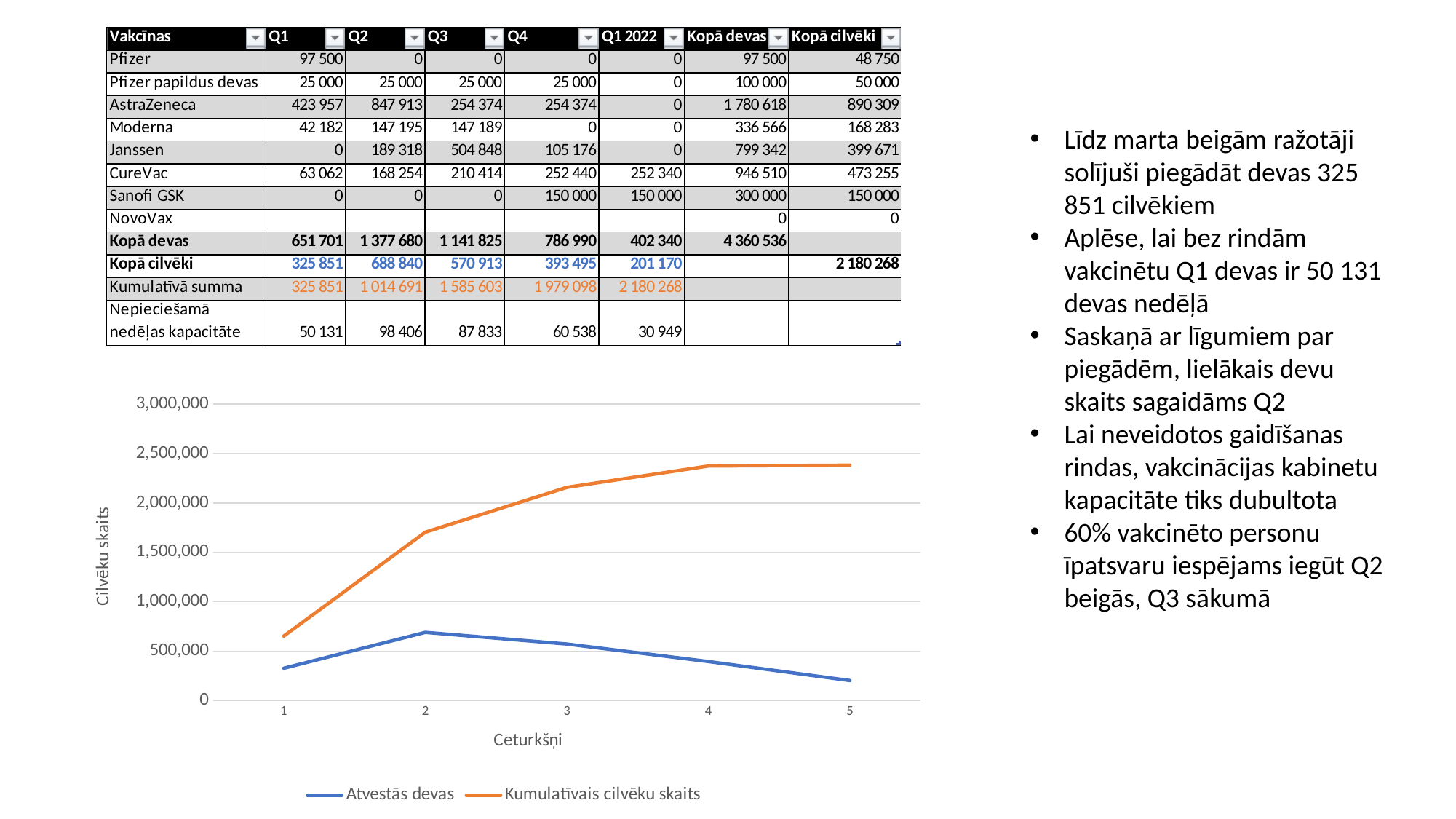
Does the Kumulatīvais cilvēku skaits line rise or fall from point 1 to point 5? rise At which x-axis point is the Atvestās devas line at its lowest value? 5 Is the value of Kumulatīvais cilvēku skaits at point 5 greater or less than 2,500,000? less At which x-axis point does the Atvestās devas line reach its highest value? 2 How many series does the chart legend list? 2 What is the title of the chart's vertical axis? Cilvēku skaits Is the value of Atvestās devas at point 5 greater or less than 500,000? less How many points along the x axis (Ceturkšņi) does each line in the chart have? 5 What are the two series named in the chart legend? Atvestās devas and Kumulatīvais cilvēku skaits What kind of chart is shown on the slide? line chart Does the Atvestās devas line rise or fall from point 2 to point 5? fall At point 3, which series has the higher value, Atvestās devas or Kumulatīvais cilvēku skaits? Kumulatīvais cilvēku skaits